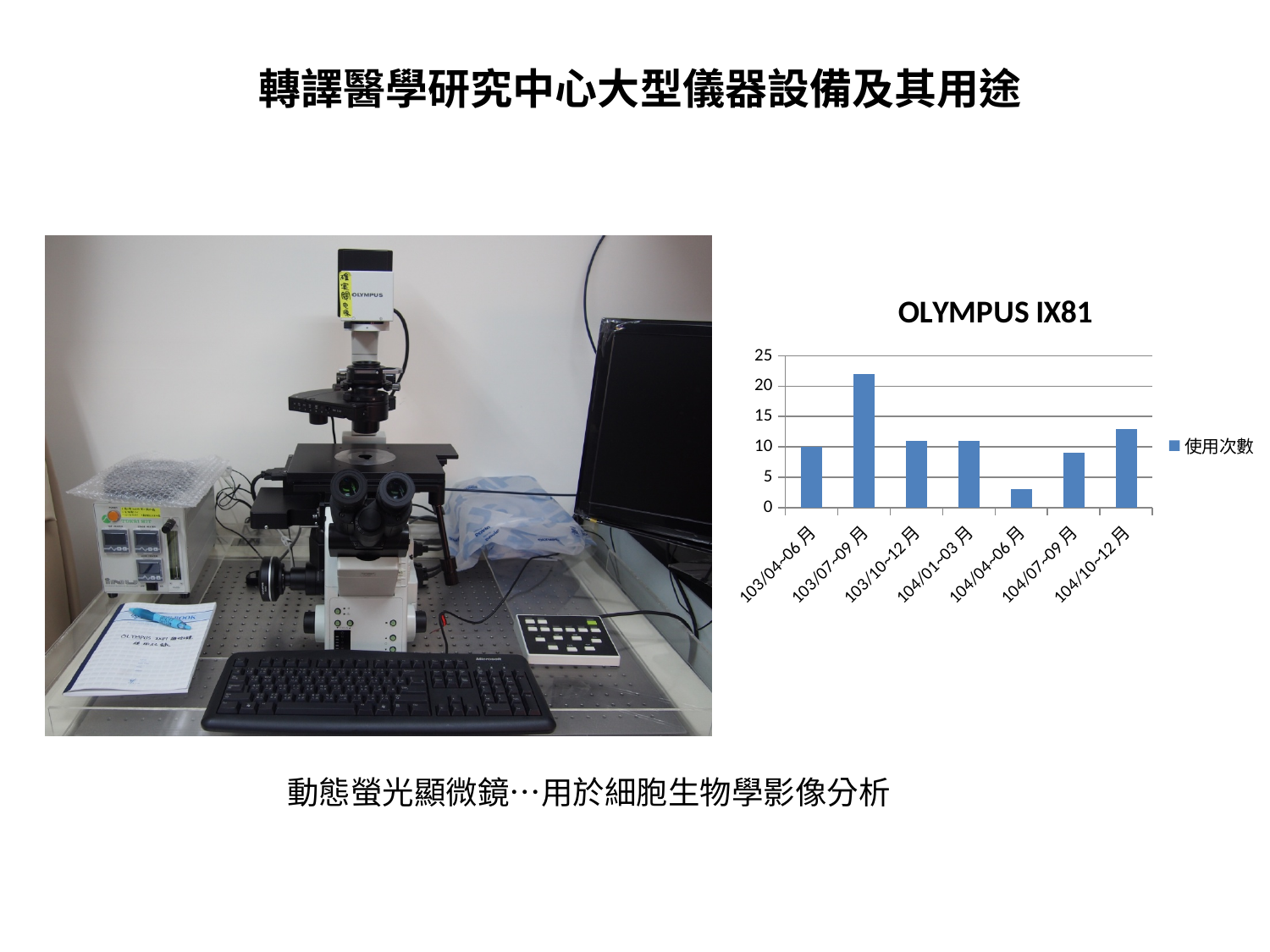
Which period has the lowest 使用次數? 104/04~06月 Which period has a larger 使用次數, 103/07-09月 or 104/10-12月? 103/07~09月 Is the value for 104/04-06月 greater or less than 5? less What kind of chart is shown on the slide? bar chart Is the value for 103/07-09月 greater or less than 20? greater What is the name of the series shown in the legend? 使用次數 How many categories (time periods) are shown on the x axis of the chart? 7 Which period has the highest 使用次數? 103/07~09月 Which period has a larger 使用次數, 104/07-09月 or 104/04-06月? 104/07~09月 How many series does the chart's legend list? 1 Is the value for 104/10-12月 greater or less than 10? greater What is the title of the chart? OLYMPUS IX81